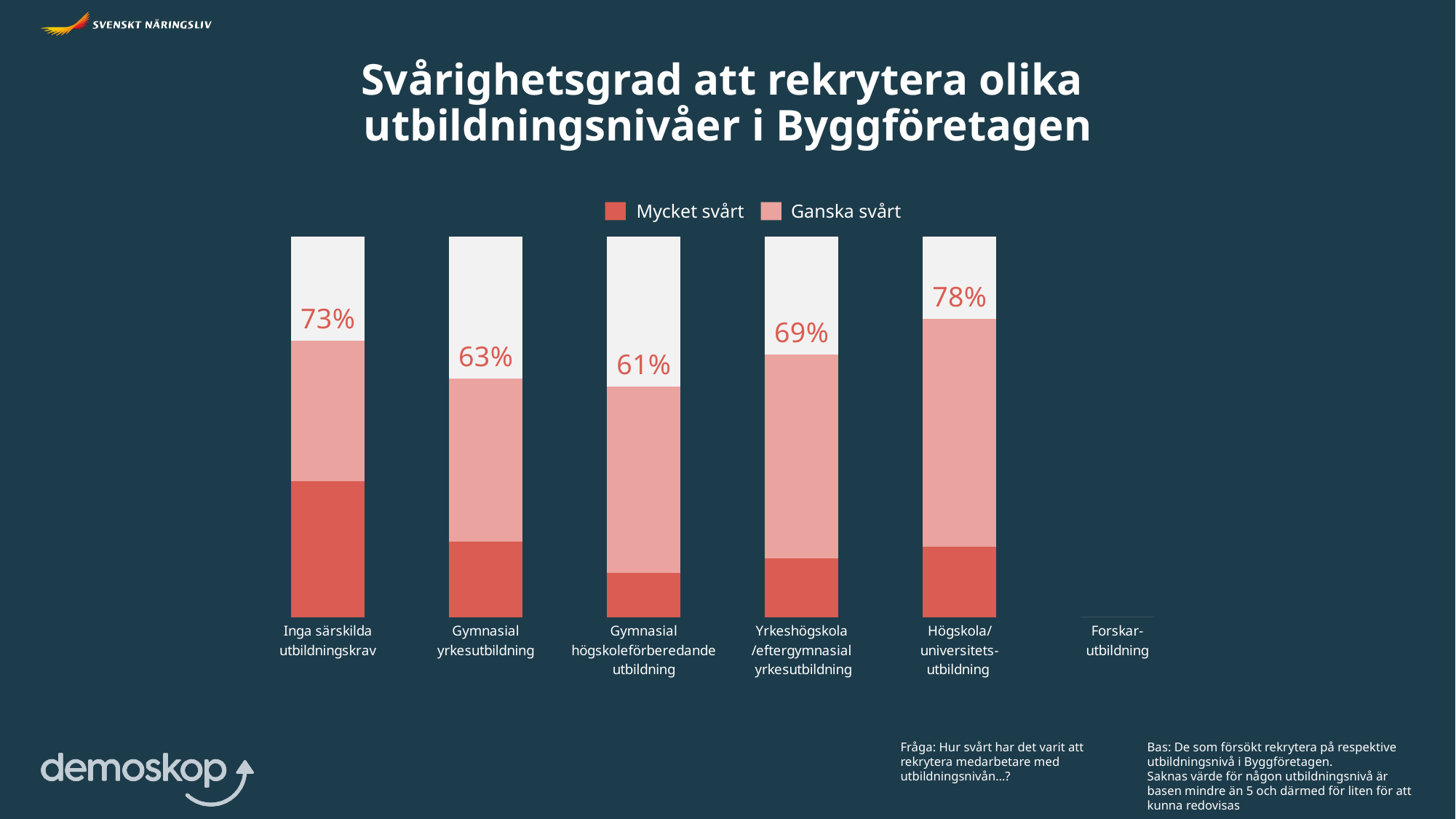
What is the total percentage shown for Yrkeshögskola/eftergymnasial yrkesutbildning? 69% How many bars with a percentage label are plotted on the chart? 5 What kind of chart is shown on the slide? Stacked bar chart What is the total percentage shown for Högskola/universitetsutbildning? 78% Which has a larger 'Mycket svårt' segment, Inga särskilda utbildningskrav or Gymnasial högskoleförberedande utbildning? Inga särskilda utbildningskrav Which has a larger total percentage, Inga särskilda utbildningskrav or Yrkeshögskola/eftergymnasial yrkesutbildning? Inga särskilda utbildningskrav Which education level has the highest total percentage? Högskola/universitetsutbildning What is the total percentage shown for Inga särskilda utbildningskrav? 73% How many series does the legend list? 2 What is the total percentage shown for Gymnasial yrkesutbildning? 63% What is the difference between the total for Högskola/universitetsutbildning and the total for Gymnasial högskoleförberedande utbildning? 17 percentage points Which education level with a plotted bar has the lowest total percentage? Gymnasial högskoleförberedande utbildning